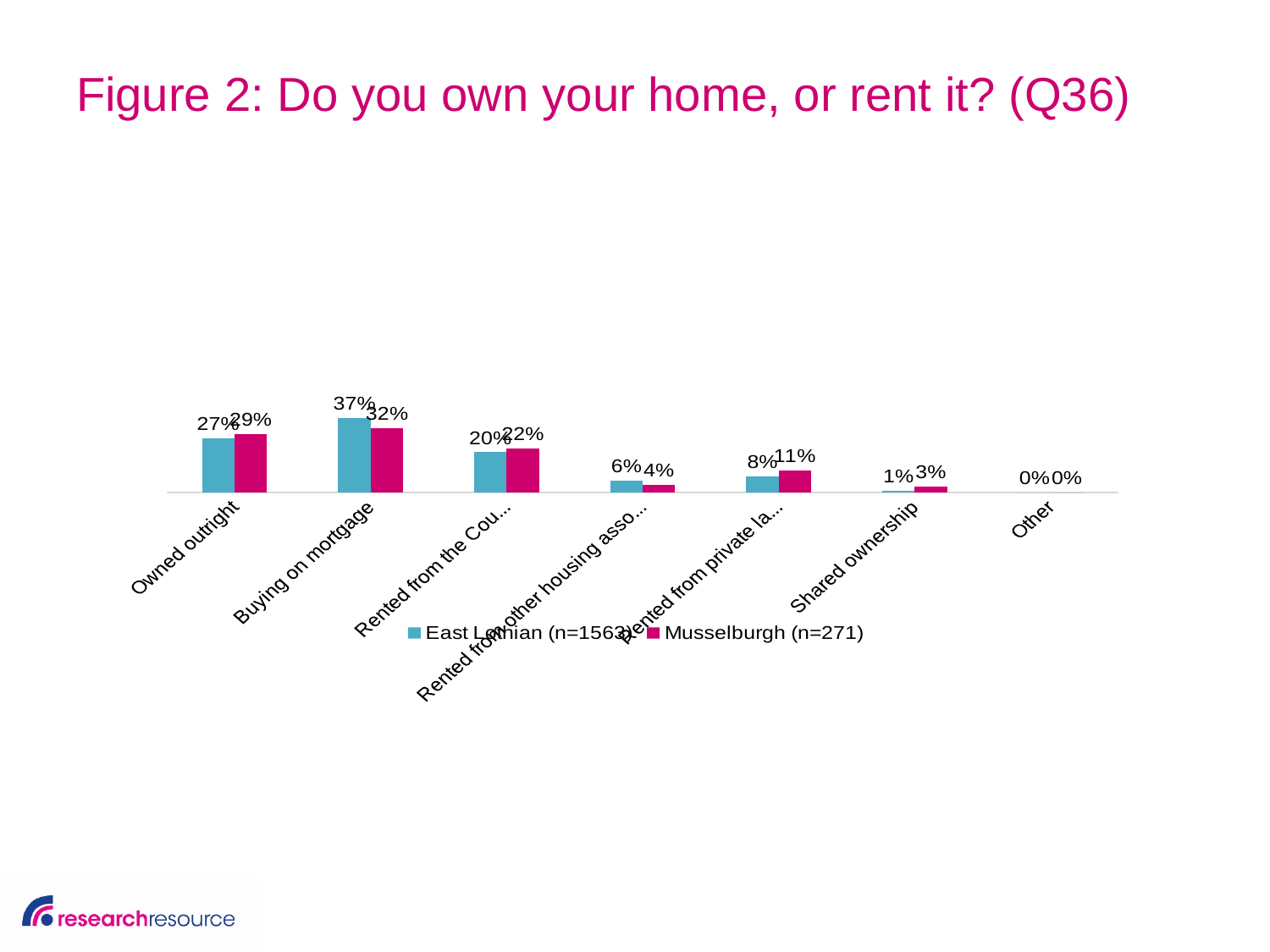
How many categories are shown on the x axis? 7 What is the value for Musselburgh (n=271) for Buying on mortgage? 32% How many series does the legend list? 2 What is the value for Musselburgh (n=271) for Shared ownership? 3% What is the difference between East Lothian (n=1563) and Musselburgh (n=271) for Buying on mortgage? 5% For Owned outright, which series has the larger value, East Lothian (n=1563) or Musselburgh (n=271)? Musselburgh (n=271) What is the title of the chart? Figure 2: Do you own your home, or rent it? (Q36) What kind of chart is shown on the slide? bar chart What is the value for East Lothian (n=1563) for Other? 0% What is the value for East Lothian (n=1563) for Owned outright? 27% Which category has the highest value for East Lothian (n=1563)? Buying on mortgage Which category has the highest value for Musselburgh (n=271)? Buying on mortgage